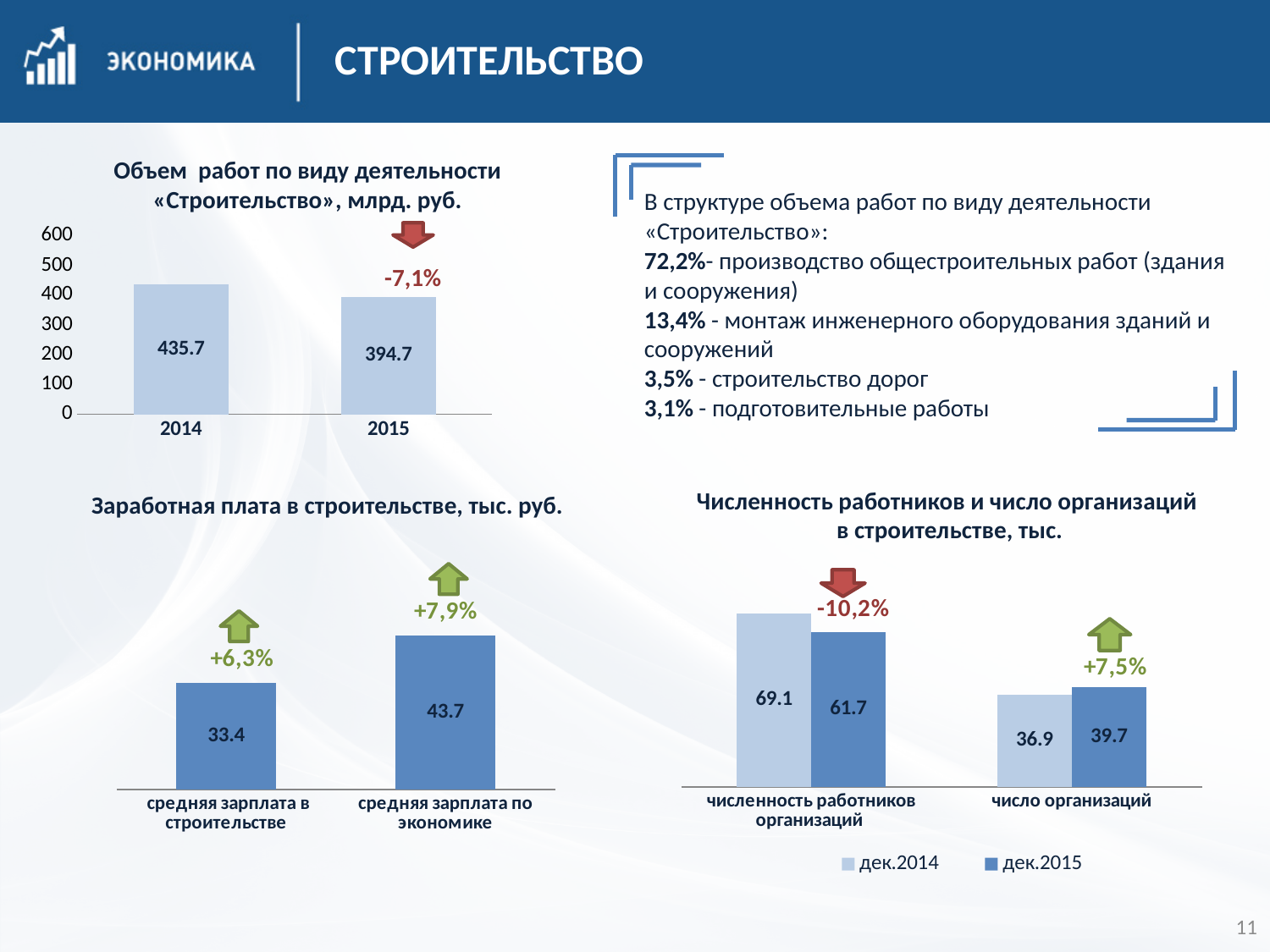
In the chart titled «Численность работников и число организаций в строительстве, тыс.», which is larger for «число организаций»: дек.2014 or дек.2015? дек.2015 In the chart titled «Заработная плата в строительстве, тыс. руб.», which category has the higher value? средняя зарплата по экономике In the chart titled «Заработная плата в строительстве, тыс. руб.», what is the value for «средняя зарплата в строительстве»? 33.4 In the chart titled «Численность работников и число организаций в строительстве, тыс.», what is the дек.2015 value for «численность работников организаций»? 61.7 In the chart titled «Объем работ по виду деятельности «Строительство», млрд. руб.», do the values rise or fall from 2014 to 2015? fall In the chart titled «Объем работ по виду деятельности «Строительство», млрд. руб.», by how much did the value fall from 2014 to 2015? 41 In the chart titled «Заработная плата в строительстве, тыс. руб.», what is the difference between the two bars? 10.3 In the chart titled «Объем работ по виду деятельности «Строительство», млрд. руб.», what is the value for 2014? 435.7 In the chart titled «Заработная плата в строительстве, тыс. руб.», what is the value for «средняя зарплата по экономике»? 43.7 In the chart titled «Численность работников и число организаций в строительстве, тыс.», what is the дек.2014 value for «число организаций»? 36.9 In the chart titled «Объем работ по виду деятельности «Строительство», млрд. руб.», what is the value for 2015? 394.7 In the chart titled «Численность работников и число организаций в строительстве, тыс.», how many series does the legend list? 2